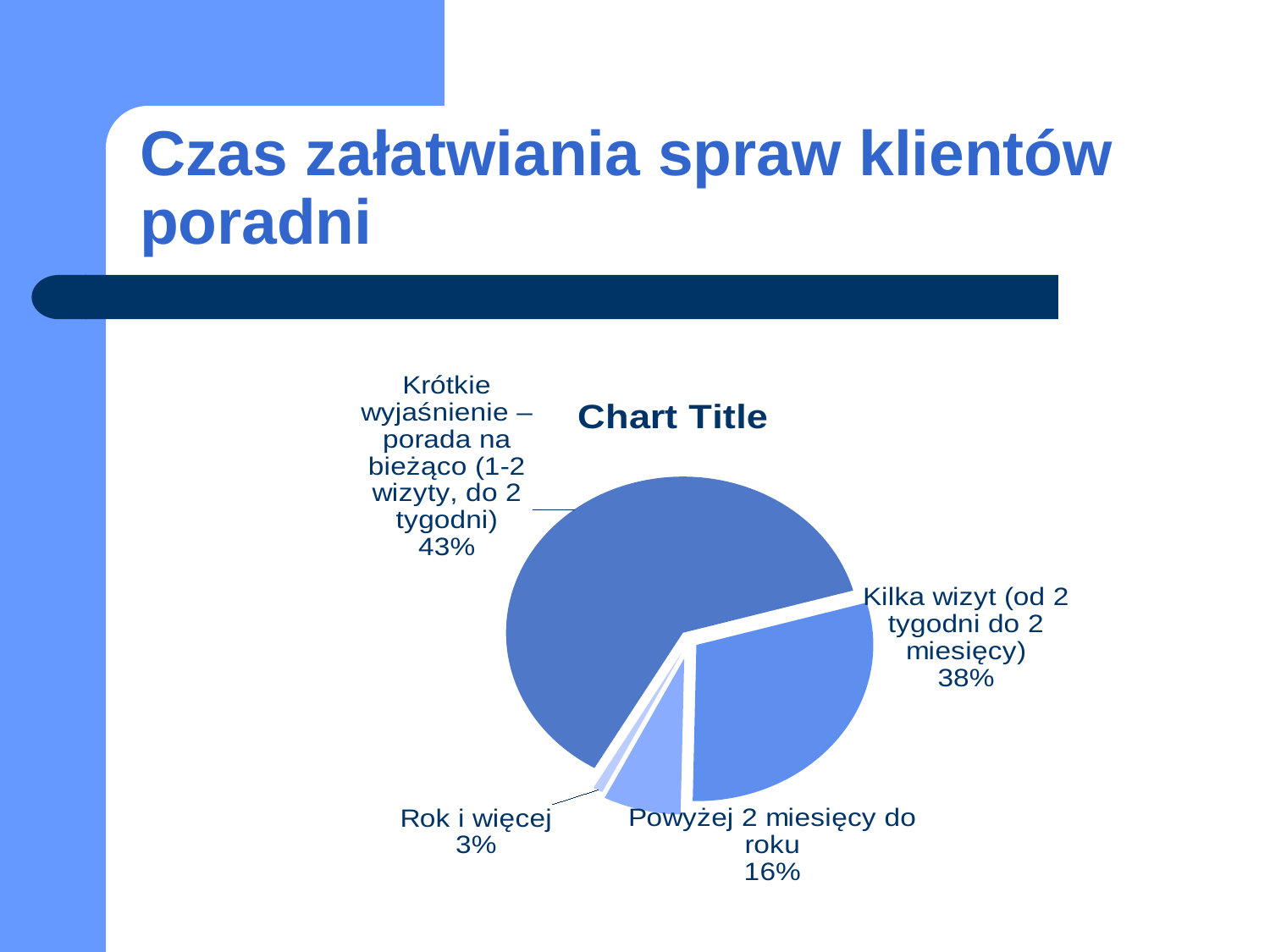
How many slices does the pie chart have? 4 Which category has the smallest slice of the pie? Rok i więcej What is the difference in percentage points between the largest and smallest slices? 40 Which category has the largest slice of the pie? Krótkie wyjaśnienie – porada na bieżąco (1-2 wizyty, do 2 tygodni) What share of the pie does "Rok i więcej" represent? 3% What share of the pie does "Krótkie wyjaśnienie – porada na bieżąco (1-2 wizyty, do 2 tygodni)" represent? 43% What is the difference in percentage points between "Kilka wizyt (od 2 tygodni do 2 miesięcy)" and "Powyżej 2 miesięcy do roku"? 22 What is the title shown on the chart itself? Chart Title What kind of chart is shown on the slide? pie chart Which is larger: the share for "Powyżej 2 miesięcy do roku" or the share for "Rok i więcej"? Powyżej 2 miesięcy do roku What share of the pie does "Powyżej 2 miesięcy do roku" represent? 16% What share of the pie does "Kilka wizyt (od 2 tygodni do 2 miesięcy)" represent? 38%